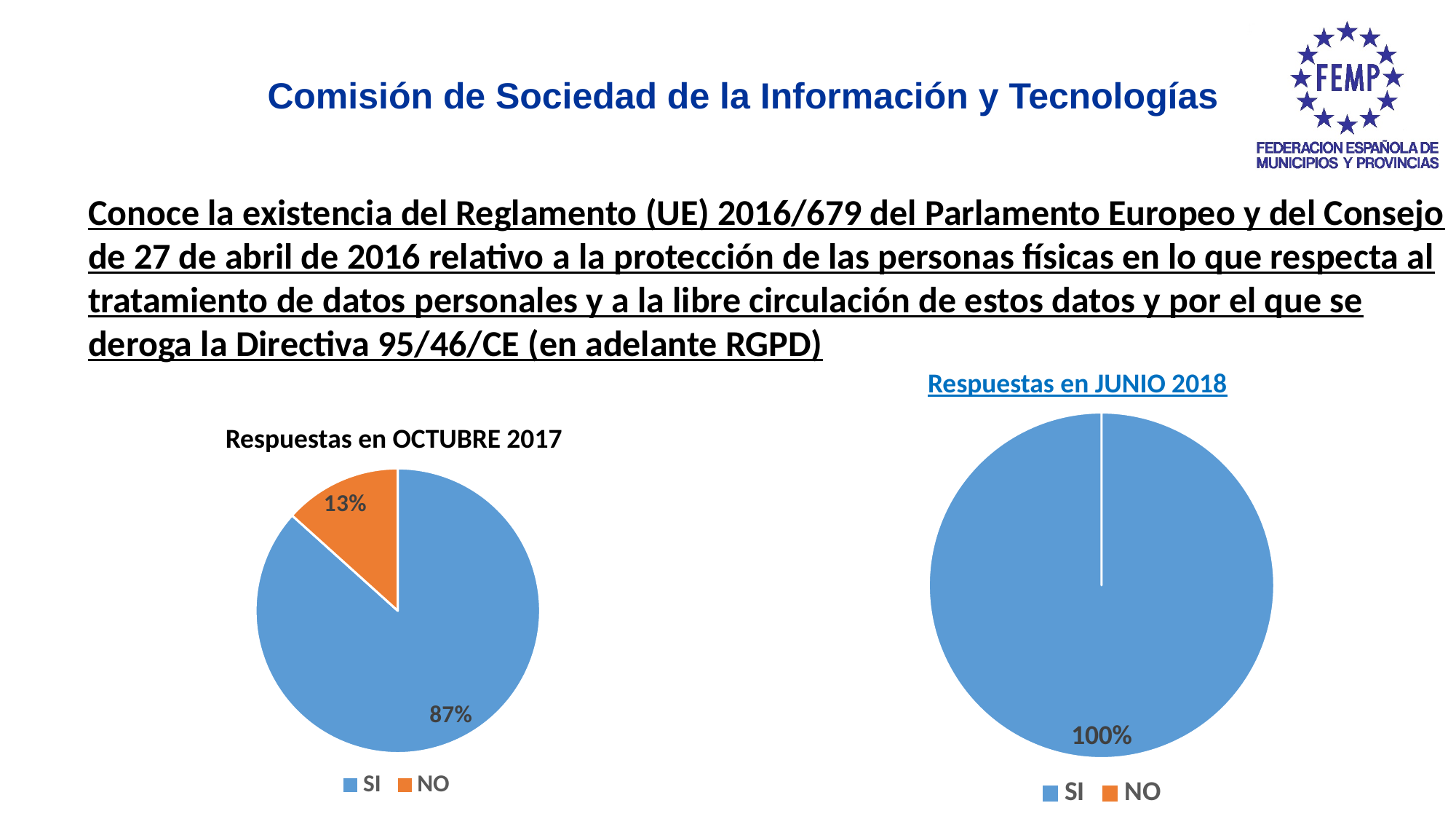
In the 'Respuestas en OCTUBRE 2017' chart, which is larger, SI or NO? SI In the 'Respuestas en OCTUBRE 2017' chart, what share of responses is SI? 87% What is the title of the pie chart on the left of the slide? Respuestas en OCTUBRE 2017 In the 'Respuestas en OCTUBRE 2017' chart, which category has the smallest slice? NO Comparing the two charts, did the SI share rise or fall from OCTUBRE 2017 to JUNIO 2018? Rise In the 'Respuestas en OCTUBRE 2017' chart, what share of responses is NO? 13% How many entries does the legend of the 'Respuestas en OCTUBRE 2017' chart list? 2 In the 'Respuestas en OCTUBRE 2017' chart, which category has the largest slice? SI In the 'Respuestas en JUNIO 2018' chart, what share of responses is SI? 100% In the 'Respuestas en JUNIO 2018' chart, what colour is the SI slice? Blue In the 'Respuestas en OCTUBRE 2017' chart, what is the difference in percentage points between SI and NO? 74 What type of chart is 'Respuestas en JUNIO 2018'? Pie chart